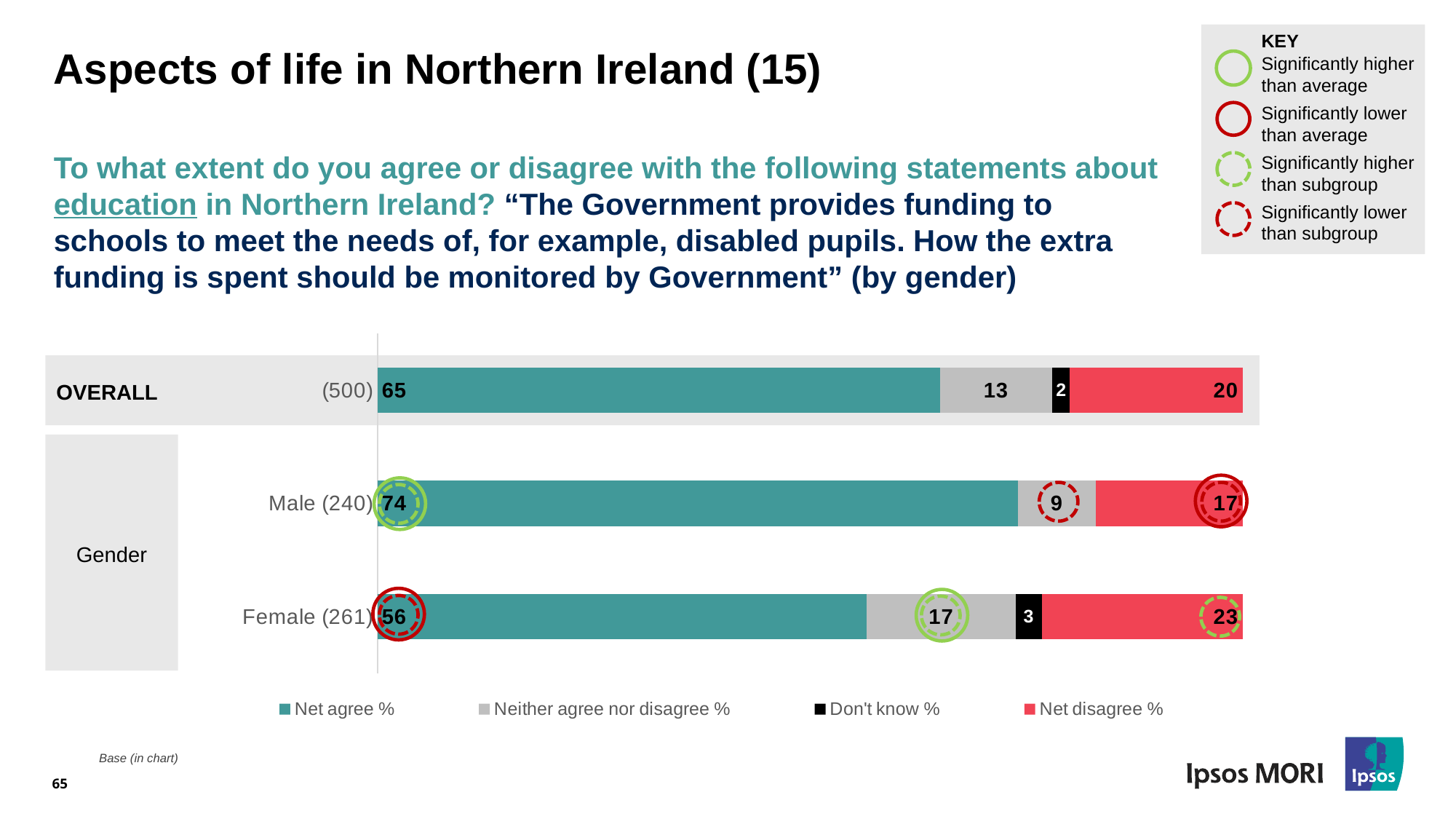
What kind of chart is shown on the slide? Stacked bar chart What is the difference in Net agree % between Male (240) and Female (261)? 18 What is the Neither agree nor disagree % for OVERALL (500)? 13 How many groups (bars) are shown in the chart? 3 What is the Net agree % for Male (240)? 74 What is the Don't know % for Female (261)? 3 How many series does the chart legend list? 4 What is the Net disagree % for Female (261)? 23 Which group has the highest Net agree %? Male (240) Is the Neither agree nor disagree % larger for Male (240) or Female (261)? Female (261) What is the total of the OVERALL (500) bar (Net agree, Neither, Don't know and Net disagree)? 100 Which group has the lowest Net disagree %? Male (240)